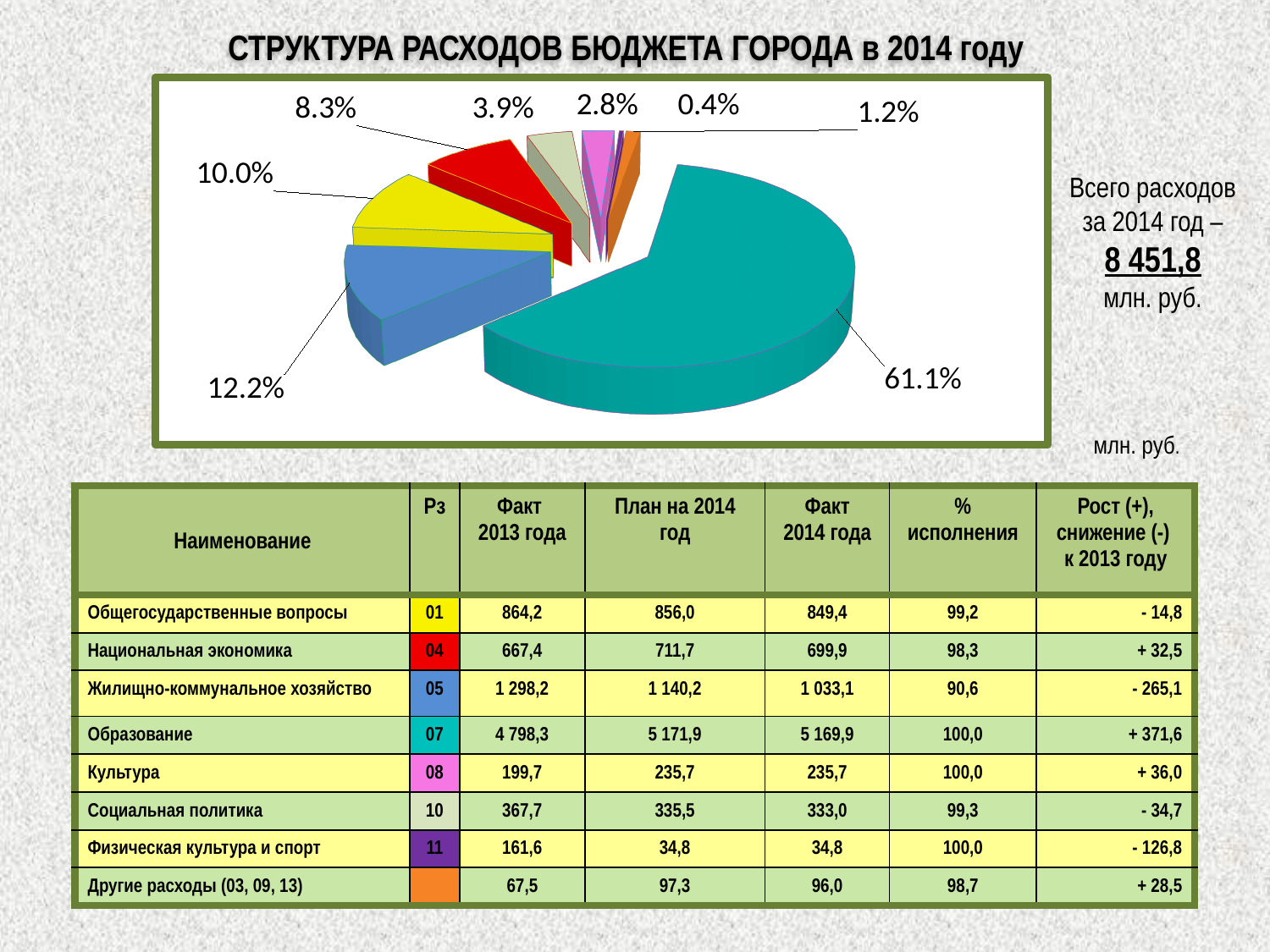
What kind of chart is shown on the slide? Pie chart How many slices does the pie chart have? 8 What share does the red slice of the pie chart represent? 8.3% Which slice is larger: the one labelled 3.9% or the one labelled 2.8%? 3.9% What share does the yellow slice of the pie chart represent? 10.0% What is the title of the slide's chart? СТРУКТУРА РАСХОДОВ БЮДЖЕТА ГОРОДА в 2014 году What share does the blue slice of the pie chart represent? 12.2% Is the share of the largest slice of the pie chart greater or less than 50%? greater What total expenditure for 2014 is stated next to the pie chart, in million rubles? 8 451,8 What is the difference in percentage points between the largest slice (61.1%) and the blue slice (12.2%)? 48.9 What is the share of the smallest slice of the pie chart? 0.4% What is the share of the largest slice of the pie chart? 61.1%